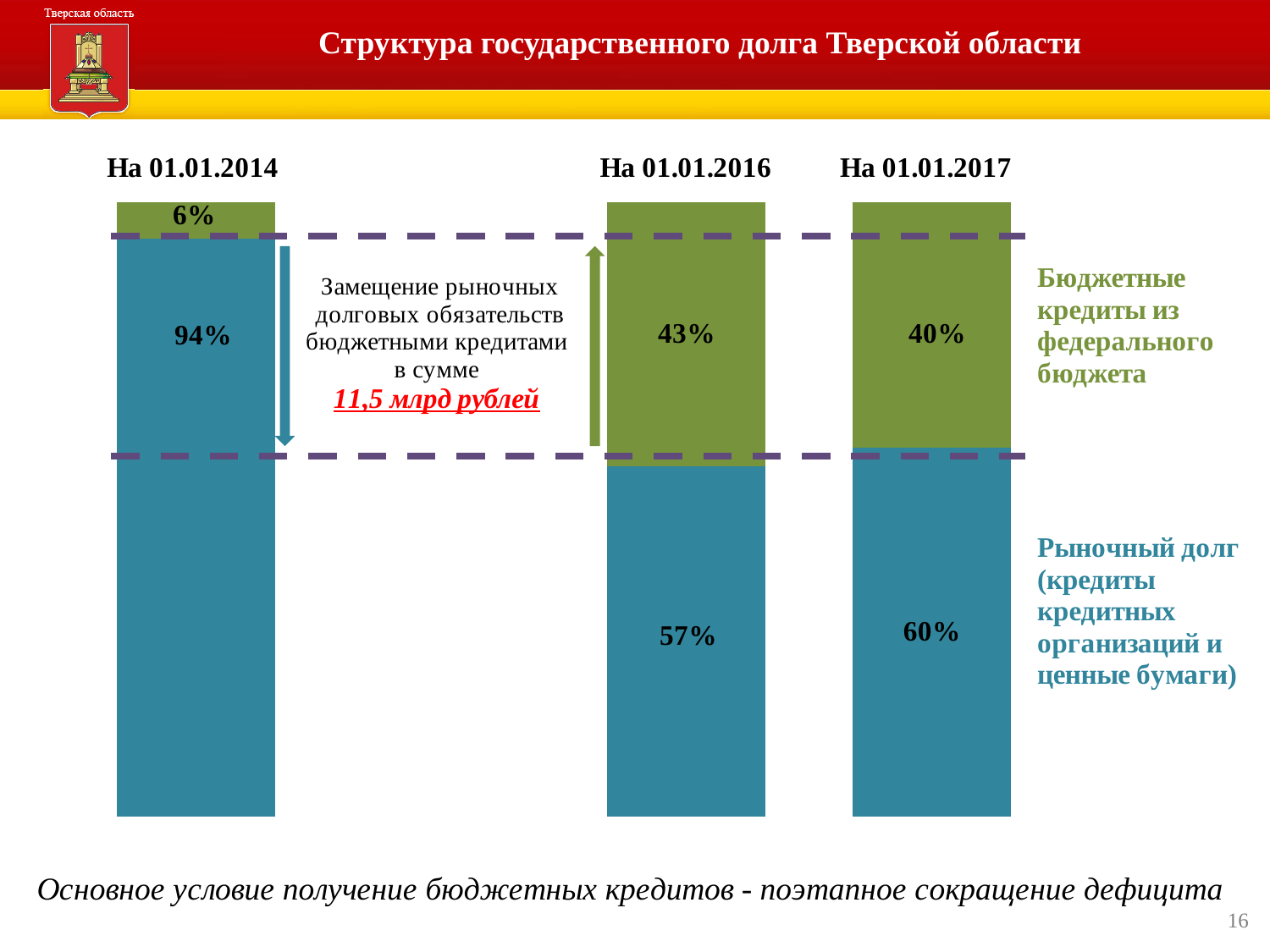
By how many percentage points did the share of market debt change between 01.01.2014 and 01.01.2016? 37 percentage points What share of the state debt was market debt as of 01.01.2017? 60% What share of the Tver region's state debt was budget credits from the federal budget as of 01.01.2014? 6% Which is larger as of 01.01.2017: the share of budget credits or the share of market debt? Market debt (60%) On which date shown was the share of market debt lowest? 01.01.2016 What amount of market debt obligations was replaced by budget credits, according to the annotation between the bars? 11,5 млрд рублей What kind of chart is shown on the slide? Stacked bar chart What share of the state debt was budget credits from the federal budget as of 01.01.2016? 43% What share of the state debt was market debt as of 01.01.2014? 94% How many debt categories (series) are shown in the stacked bars? 2 How many dates (bars) are shown in the chart? 3 On which date shown was the share of budget credits from the federal budget highest? 01.01.2016